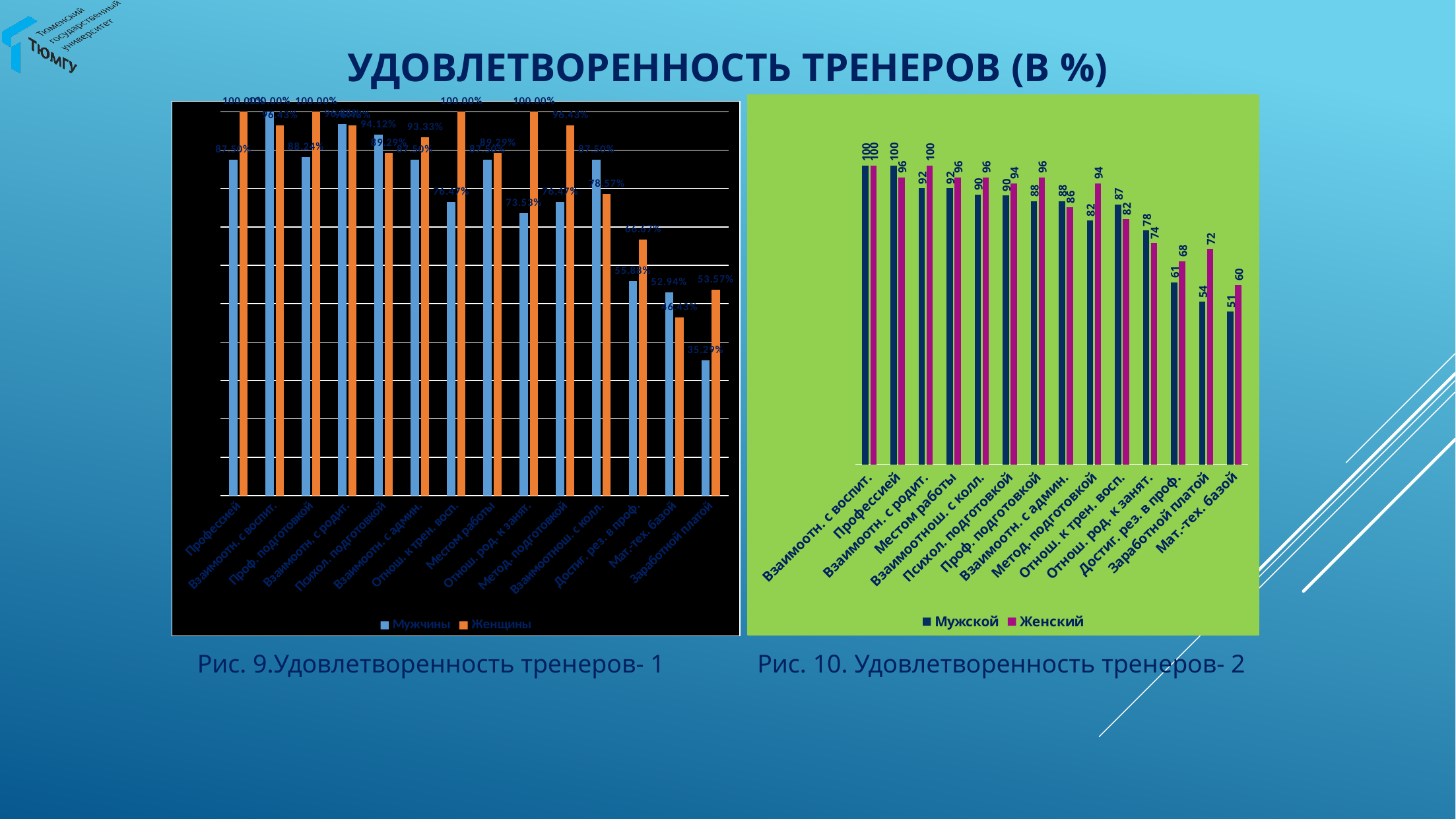
What are the two series listed in the legend of Рис. 9 (the left chart)? Мужчины and Женщины How many series does the legend of Рис. 10 (the right chart) list? 2 In Рис. 10 (the right chart), what is the Женский value for Метод. подготовкой? 94 What kind of chart is Рис. 10 (the right chart)? bar chart In Рис. 10 (the right chart), which series has the larger value for Отнош. к трен. восп., Мужской or Женский? Мужской In Рис. 9 (the left chart), what is the Мужчины value for Заработной платой? 35.29% In Рис. 10 (the right chart), what is the Мужской value for Заработной платой? 54 In Рис. 9 (the left chart), what is the Женщины value for Заработной платой? 53.57% How many categories are shown on the x axis of Рис. 10 (the right chart)? 14 In Рис. 10 (the right chart), which category has the lowest Мужской value? Мат.-тех. базой In Рис. 10 (the right chart), what is the difference between the Женский and Мужской values for Заработной платой? 18 In Рис. 10 (the right chart), which category has the lowest Женский value? Мат.-тех. базой